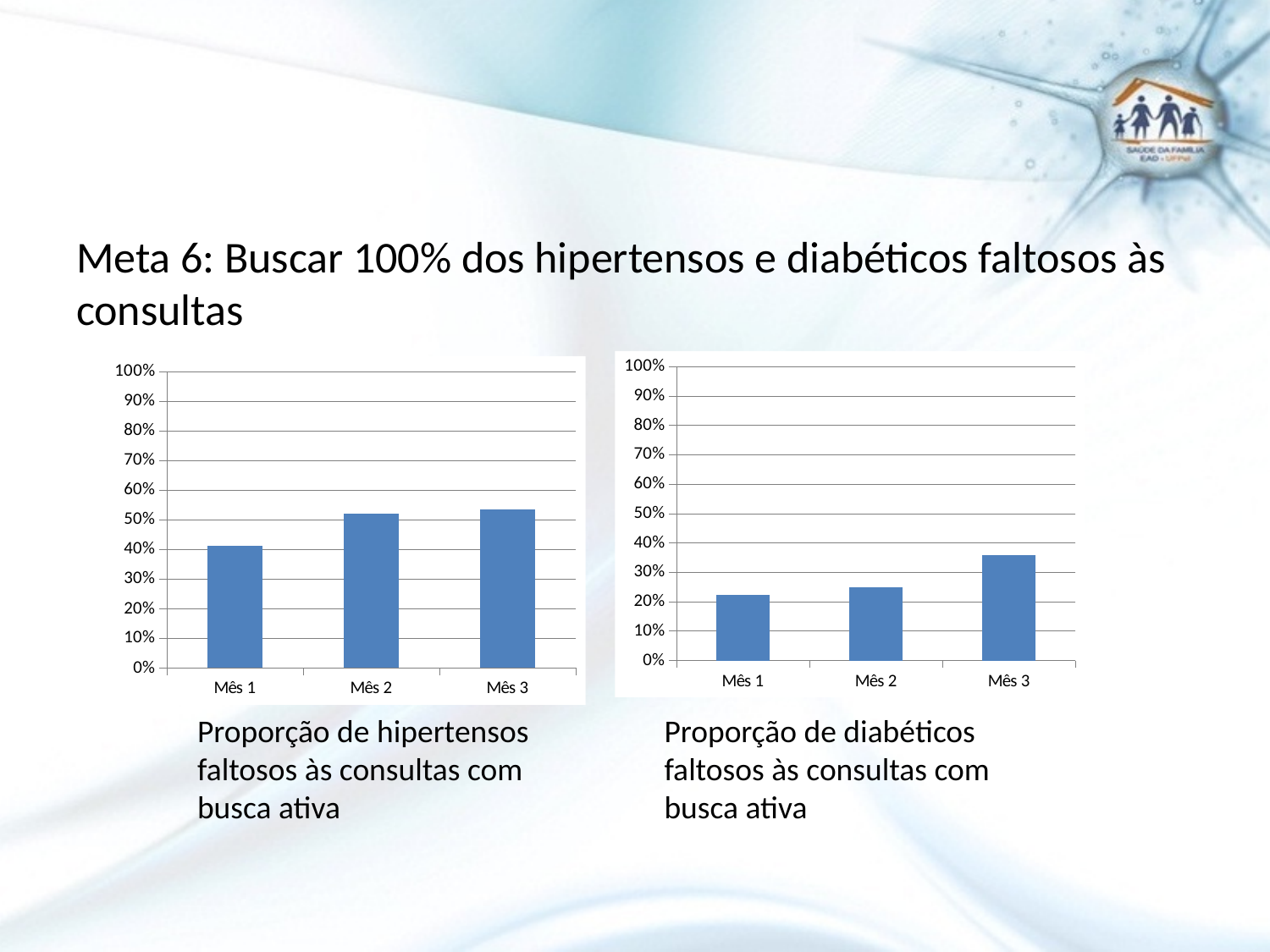
What is the maximum value shown on the y axis of the left chart (hipertensos)? 100% In the right chart (diabéticos), is the value for Mês 3 greater or less than 30%? greater How many categories are shown on the x axis of the right chart, 'Proporção de diabéticos faltosos às consultas com busca ativa'? 3 In the left chart (hipertensos), which month has the lowest value? Mês 1 In the right chart (diabéticos), do the values rise or fall from Mês 1 to Mês 3? rise In the left chart (hipertensos), is the value for Mês 1 larger or smaller than the value for Mês 3? smaller In the right chart (diabéticos), is the value for Mês 1 greater or less than 30%? less What kind of chart is the left chart, 'Proporção de hipertensos faltosos às consultas com busca ativa'? bar chart In the right chart (diabéticos), which month has the highest value? Mês 3 In the left chart (hipertensos), is the value for Mês 1 greater or less than 50%? less In the right chart (diabéticos), which is larger, the value for Mês 1 or the value for Mês 3? Mês 3